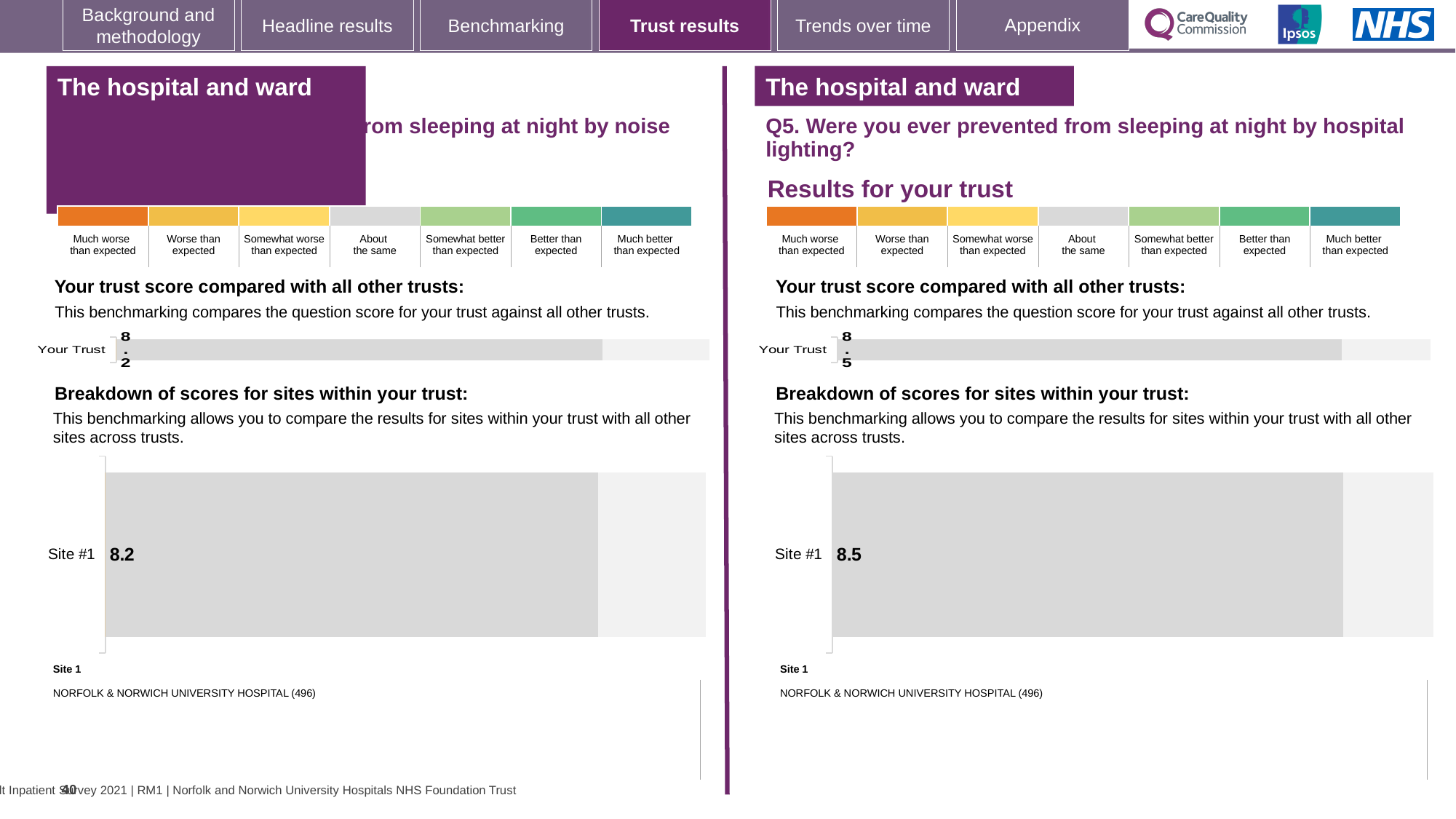
On the right-hand chart for Q5 (hospital lighting), what is the score shown for Your Trust? 8.5 In the right-hand 'Breakdown of scores for sites within your trust' chart, what is the score for Site #1? 8.5 What kind of chart is used to show the Site #1 score in the left-hand breakdown section? bar chart How many rating categories are shown in the colour scale above the right-hand 'Your trust score' chart? 7 On the right-hand side, is the Your Trust score the same as the Site #1 score? yes In the left-hand 'Breakdown of scores for sites within your trust' chart, what is the score for Site #1? 8.2 What is the difference between the Site #1 score in the right-hand breakdown chart and the Site #1 score in the left-hand breakdown chart? 0.3 Is the Site #1 score higher in the left-hand breakdown chart or the right-hand breakdown chart? right-hand chart On the left-hand chart about being prevented from sleeping at night by noise, what is the score shown for Your Trust? 8.2 How many sites are shown in the right-hand 'Breakdown of scores for sites within your trust' chart? 1 Which site is listed as Site 1 below the right-hand breakdown chart? NORFOLK & NORWICH UNIVERSITY HOSPITAL (496)